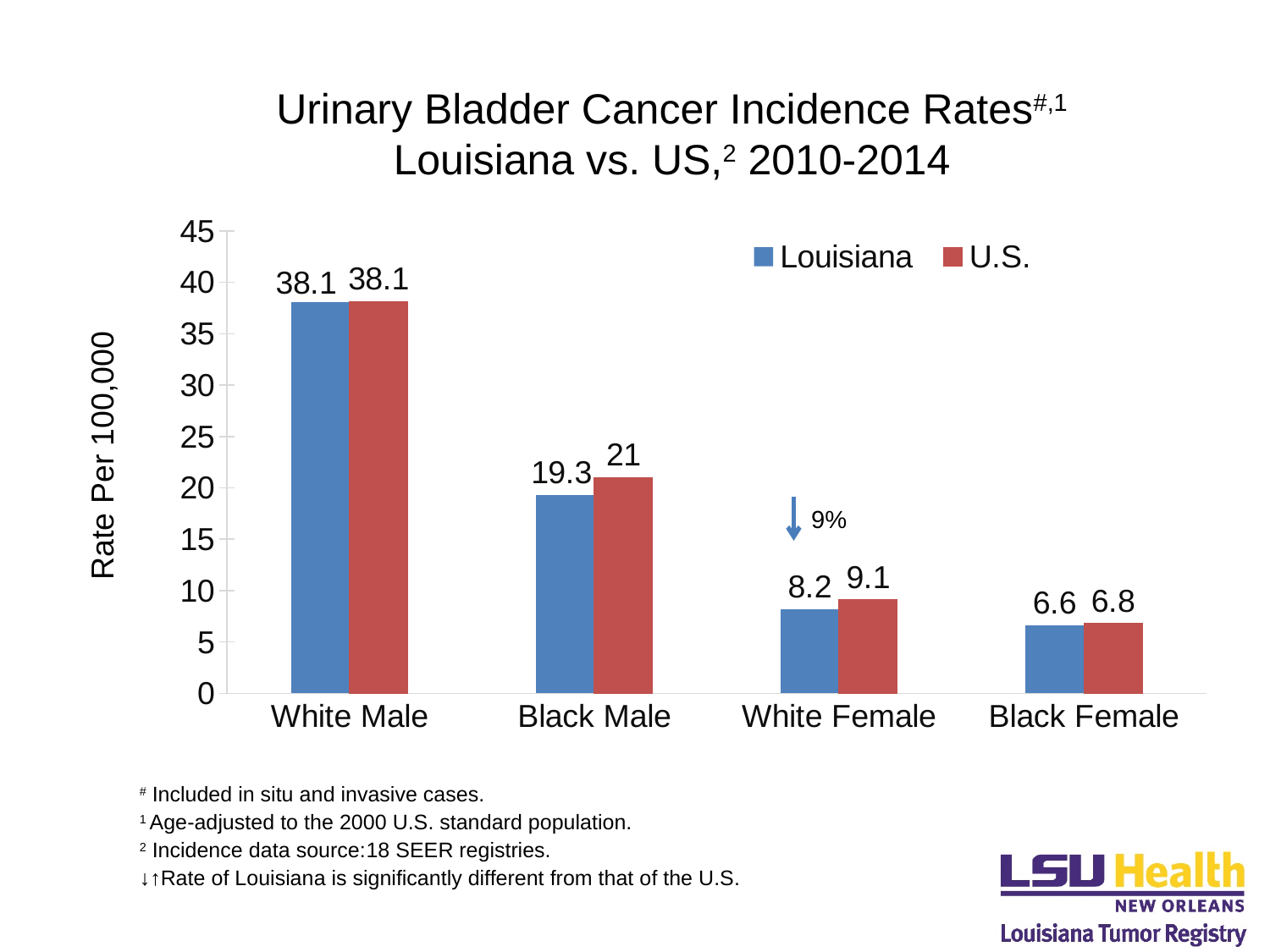
What is the Louisiana urinary bladder cancer incidence rate for Black Male? 19.3 Do the Louisiana rates rise or fall from White Male to Black Female along the x axis? Fall How many categories are shown on the x axis? 4 What is the difference between the U.S. and Louisiana rates for Black Male? 1.7 What is the Louisiana rate for Black Female? 6.6 Which category has the lowest U.S. rate? Black Female What kind of chart is shown on the slide? Bar chart Which category has the highest Louisiana rate? White Male How many series does the legend list? 2 What is the label of the y axis? Rate Per 100,000 What is the U.S. urinary bladder cancer incidence rate for White Female? 9.1 Which is larger for White Female, the Louisiana rate or the U.S. rate? U.S.